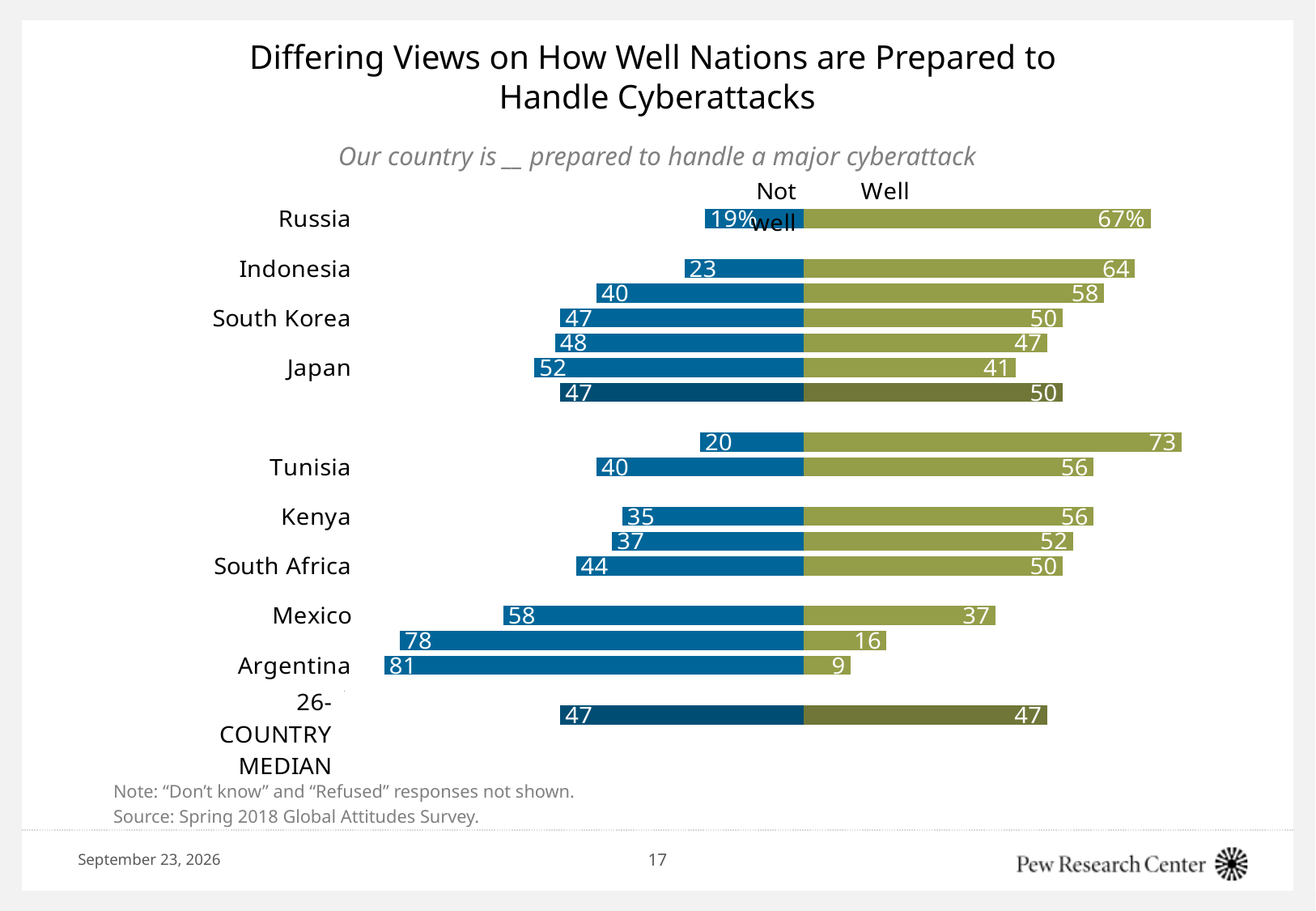
Which has a larger 'Not well' value, Mexico or Japan? Mexico What is the 'Well' value for the 26-country median? 47 What is the 'Not well' value for Argentina? 81 What are the two series names shown above the bars? Not well and Well Which labeled country has the highest 'Not well' value? Argentina What is the 'Well' value for Japan? 41 What is the difference between the 'Well' and 'Not well' values for Russia? 48 What is the 'Not well' value for Mexico? 58 What percentage of respondents in Russia say their country is well prepared to handle a major cyberattack? 67% How many series does the chart show? 2 Which labeled country has the lowest 'Well' value? Argentina What kind of chart is shown on the slide? Bar chart